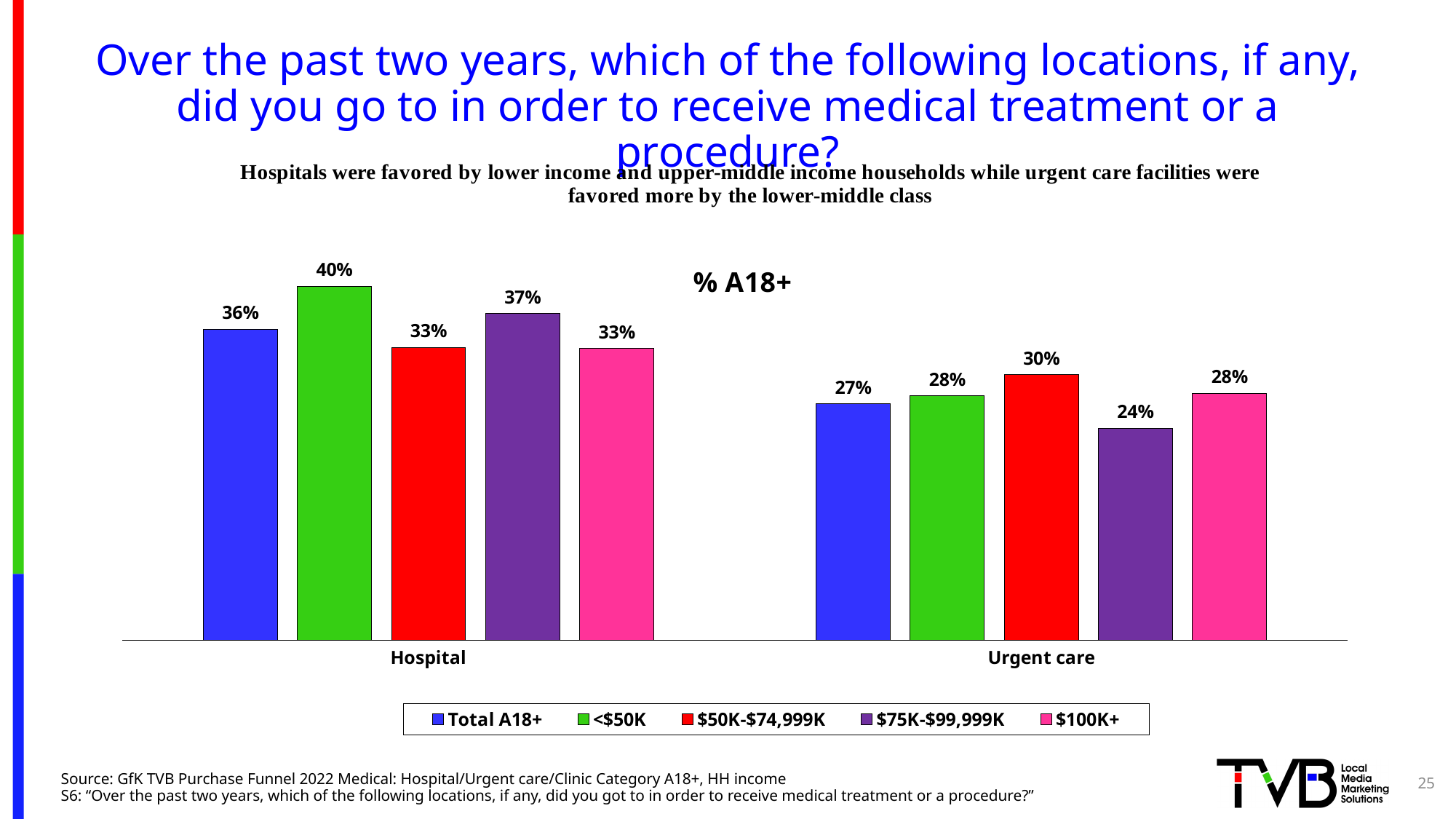
What kind of chart is shown on the slide? Bar chart How many categories are shown on the x axis? 2 What is the difference between the Total A18+ values for Hospital and Urgent care? 9% Which series has the lowest value in the Urgent care category? $75K-$99,999K What is the value for the <$50K series in the Urgent care category? 28% What is the difference between the <$50K value and the $100K+ value in the Hospital category? 7% What is the value for the $75K-$99,999K series in the Urgent care category? 24% What colour are the bars for the $100K+ series? Pink Which income series has the highest value in the Hospital category? <$50K Which is larger: the $50K-$74,999K value for Hospital or for Urgent care? Hospital How many series does the legend list? 5 What is the value for Total A18+ in the Hospital category? 36%